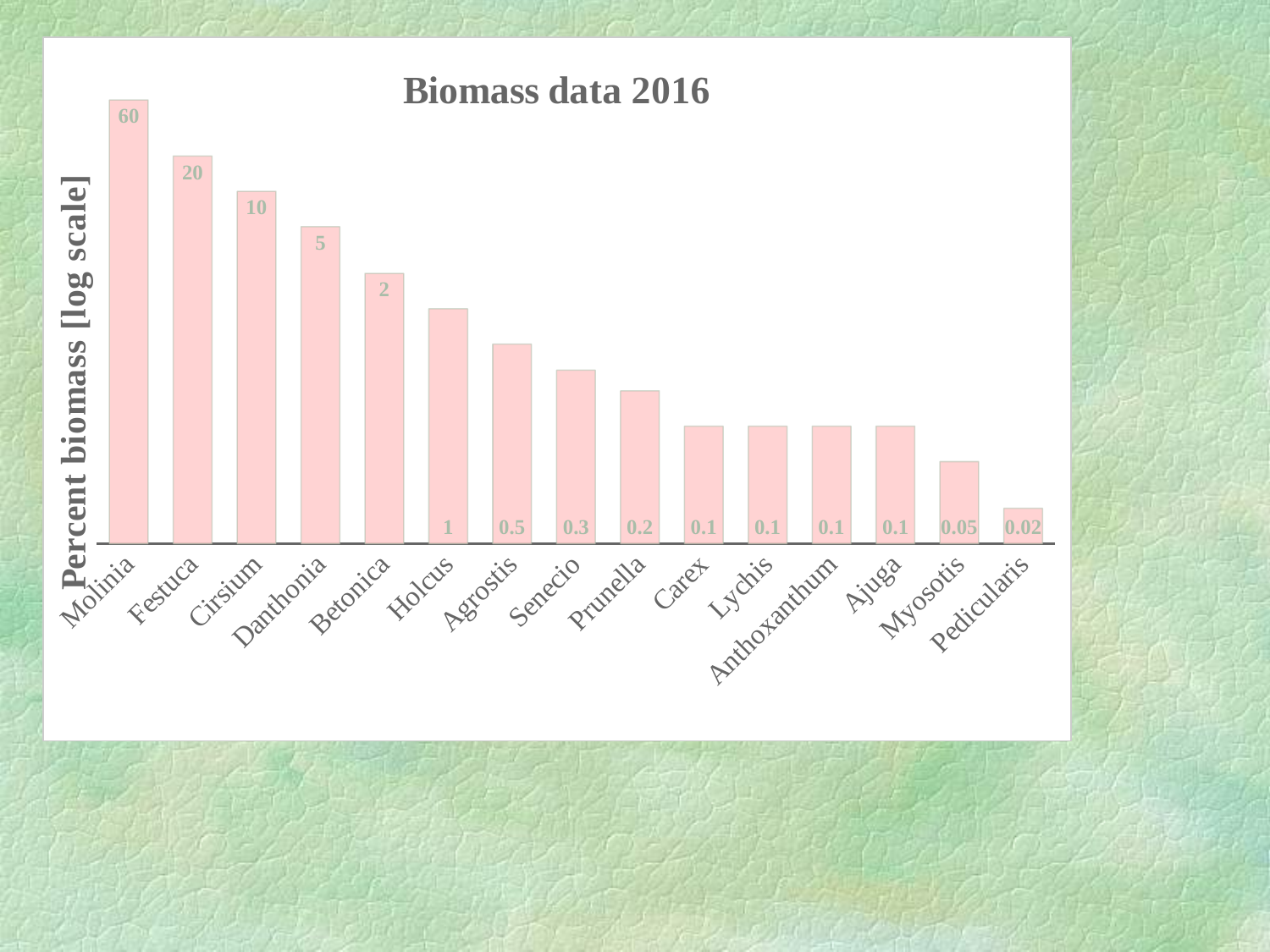
What is the value for Danthonia? 5 What is the value for Senecio? 0.3 Which is larger, the value for Holcus or the value for Myosotis? Holcus What is the value for Pedicularis? 0.02 What is the title of the chart? Biomass data 2016 What kind of chart is this? Bar chart What is the difference between the values for Molinia and Festuca? 40 Which category has the lowest value? Pedicularis What is the value for Molinia? 60 What is the difference between the values for Cirsium and Betonica? 8 How many categories are shown on the x axis? 15 Which category has the highest value? Molinia